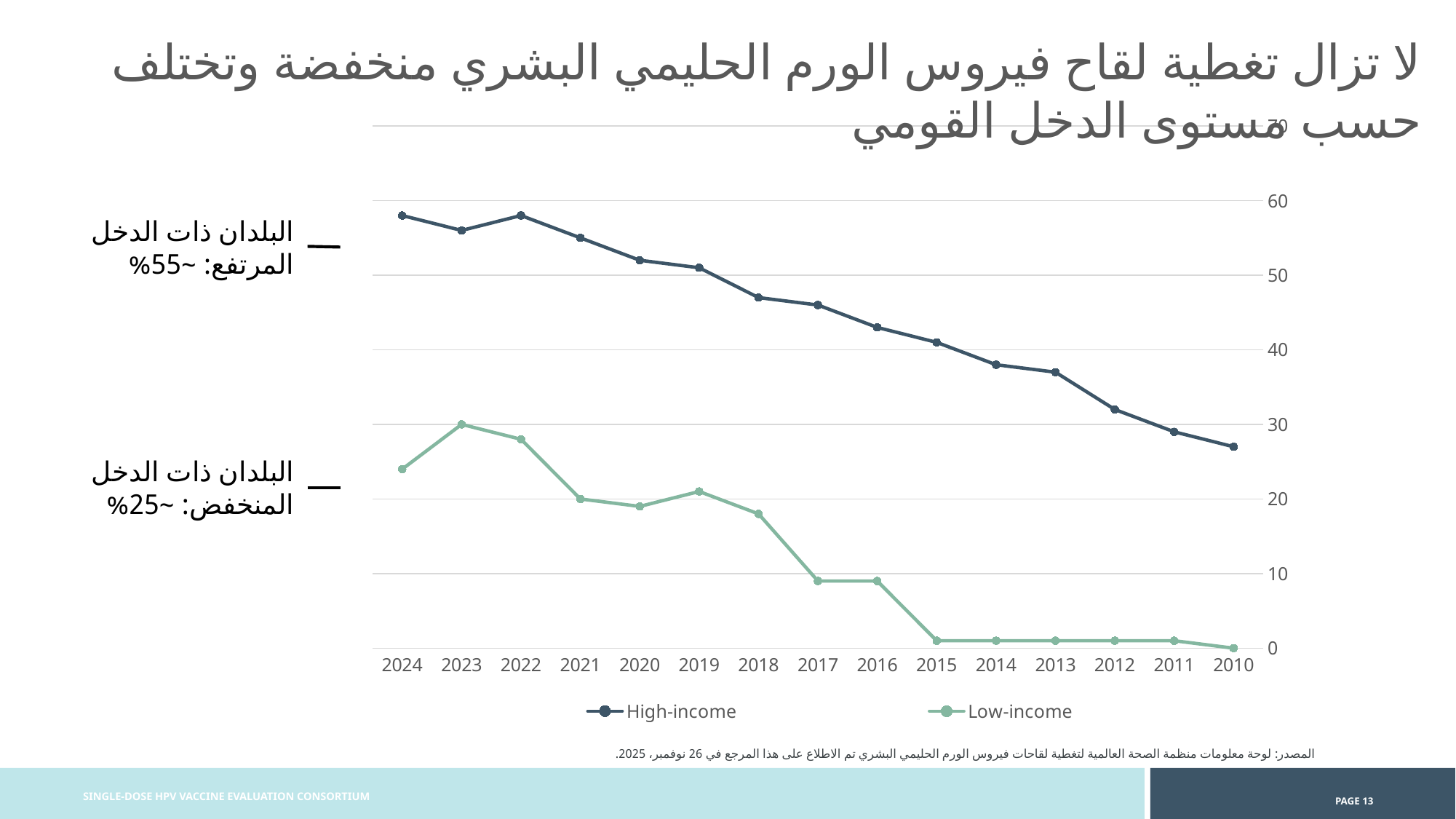
What kind of chart is shown on the slide? line chart Which series does the legend list besides High-income? Low-income Is the Low-income value for 2014 greater or less than 10? less Is the High-income value for 2010 greater or less than 30? less In which year is the High-income series at its lowest? 2010 In which year is the Low-income series at its highest? 2023 Is the Low-income value for 2018 greater or less than 20? less How many years are plotted along the x axis? 15 How many series does the legend list? 2 In 2020, which series has the larger value, High-income or Low-income? High-income